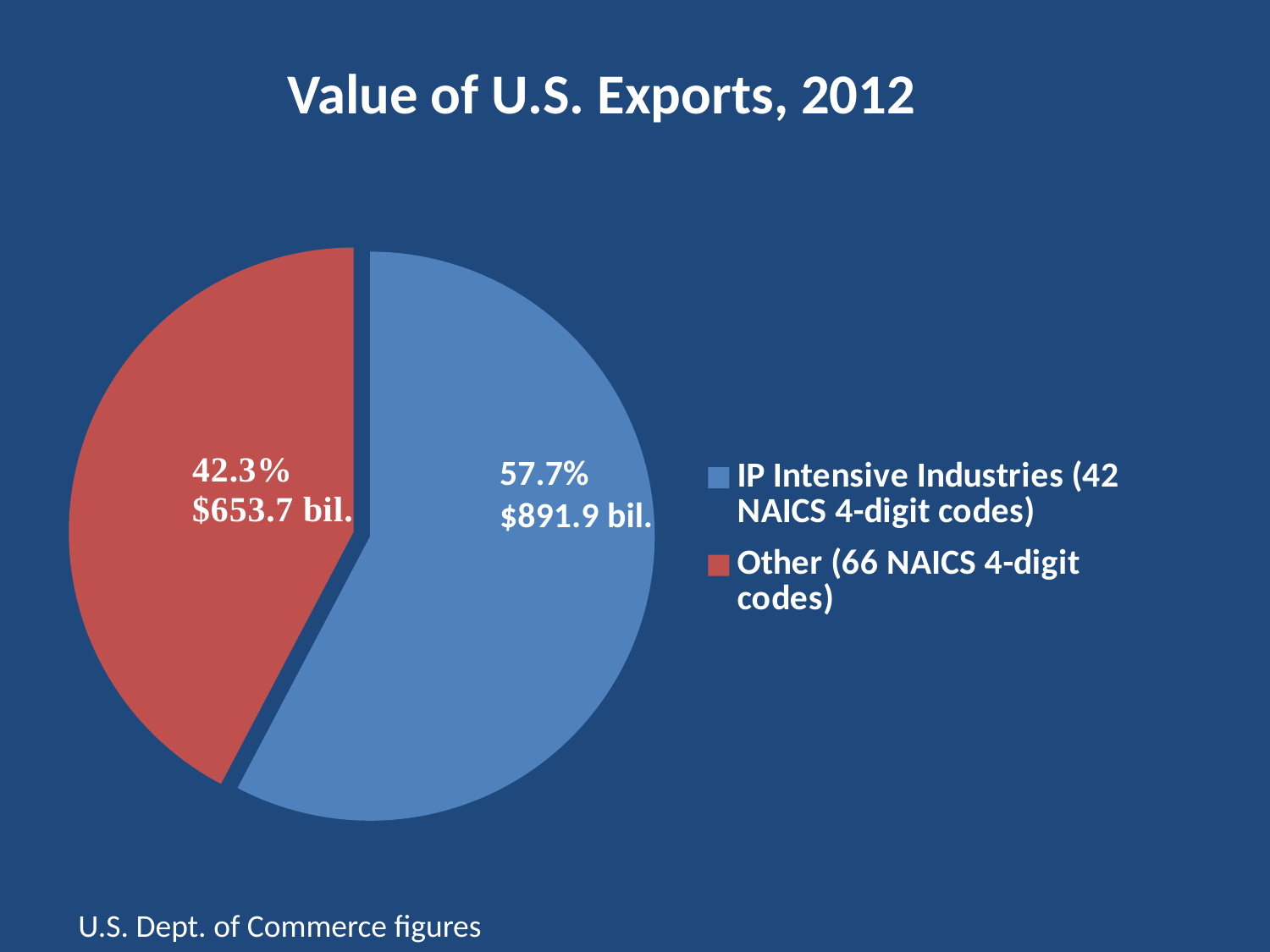
How many categories does the pie chart show? 2 What kind of chart is shown on the slide? pie chart What is the difference in export value between IP Intensive Industries and Other? $238.2 bil. What is the title of the chart? Value of U.S. Exports, 2012 Which is larger, the export value for IP Intensive Industries or for Other? IP Intensive Industries What colour is the slice for Other (66 NAICS 4-digit codes)? red Which category has the smallest slice of the pie? Other (66 NAICS 4-digit codes) What is the export value shown for IP Intensive Industries (42 NAICS 4-digit codes)? $891.9 bil. What share of the pie does IP Intensive Industries (42 NAICS 4-digit codes) represent? 57.7% What share of the pie does Other (66 NAICS 4-digit codes) represent? 42.3% Which category has the largest slice of the pie? IP Intensive Industries (42 NAICS 4-digit codes) What is the export value shown for Other (66 NAICS 4-digit codes)? $653.7 bil.